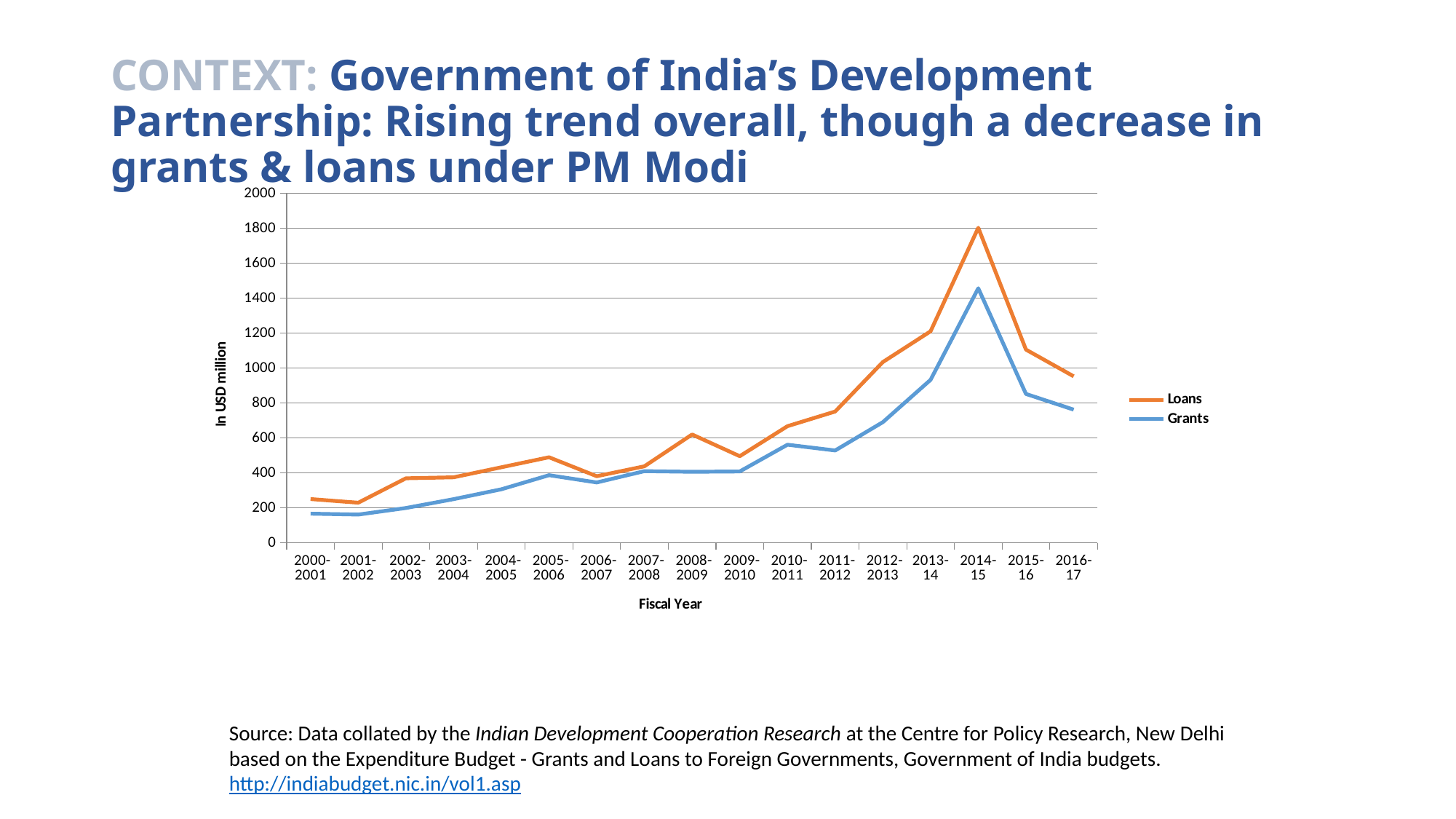
What kind of chart is shown on the slide? Line chart In which fiscal year does the Grants series reach its highest value? 2014-15 Is the value for Grants in 2014-15 greater or less than 1200? greater Is the value for Loans in 2016-17 greater or less than 1000? less How many fiscal years are plotted along the x axis? 17 In which fiscal year does the Loans series reach its highest value? 2014-15 Is the value for Grants in 2000-2001 greater or less than 200? less What is the label on the chart's vertical axis? In USD million Do the Grants values rise or fall from 2014-15 to 2016-17? Fall How many series does the chart's legend list? 2